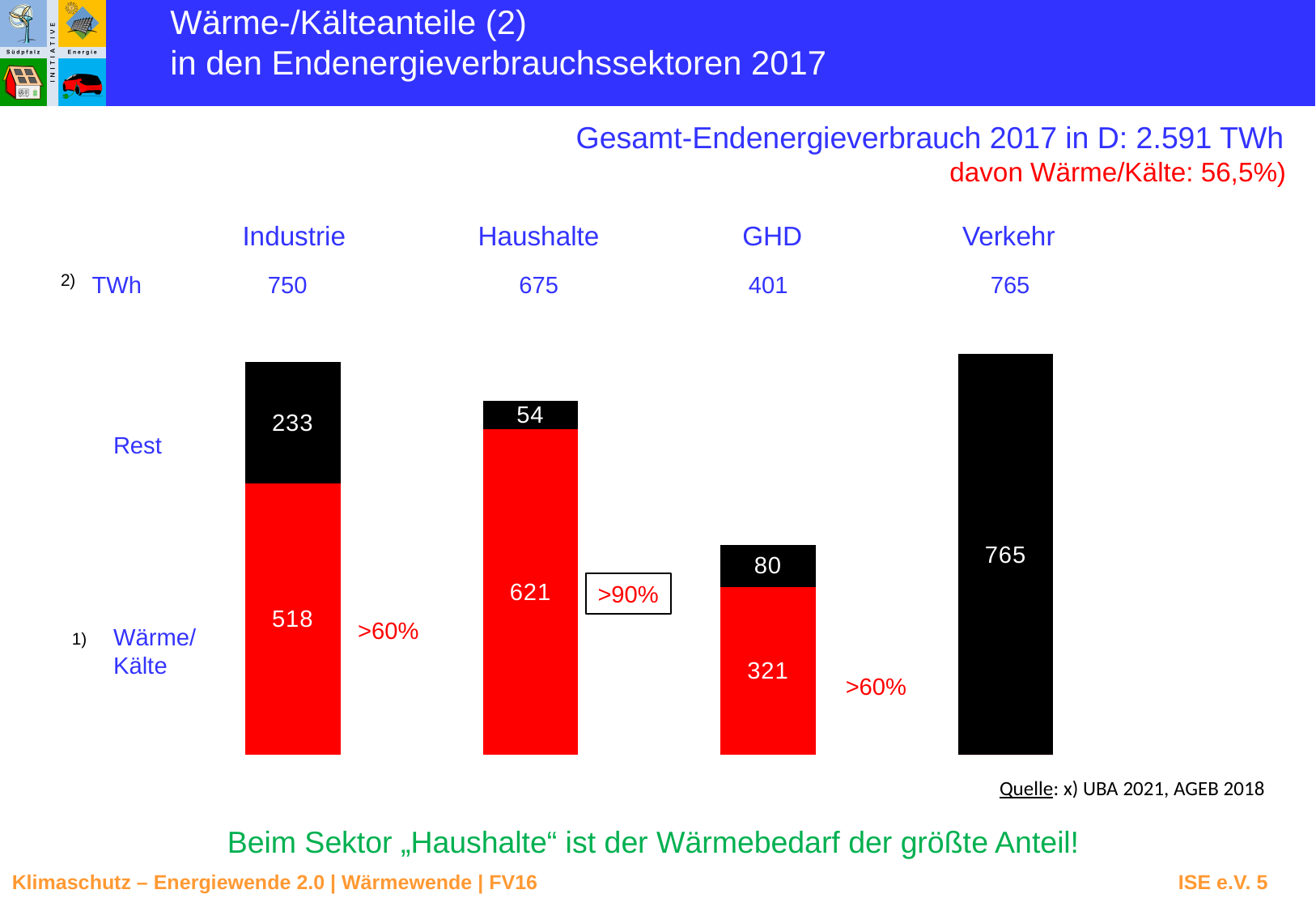
Which sector has the lowest total TWh value? GHD How many sectors are shown in the chart? 4 Which sector has the highest Wärme/Kälte value? Haushalte What is the Rest value for Haushalte? 54 What is the Wärme/Kälte value for GHD? 321 What colour represents the Wärme/Kälte segment in the bars? Red What is the Wärme/Kälte value for Industrie? 518 What is the total TWh value shown for Verkehr? 765 What kind of chart is shown on the slide? Stacked bar chart What is the difference between the Wärme/Kälte values for Industrie and GHD? 197 What is the total of the stacked bar for Haushalte? 675 Which is larger, the Rest value for Industrie or the Rest value for GHD? Industrie